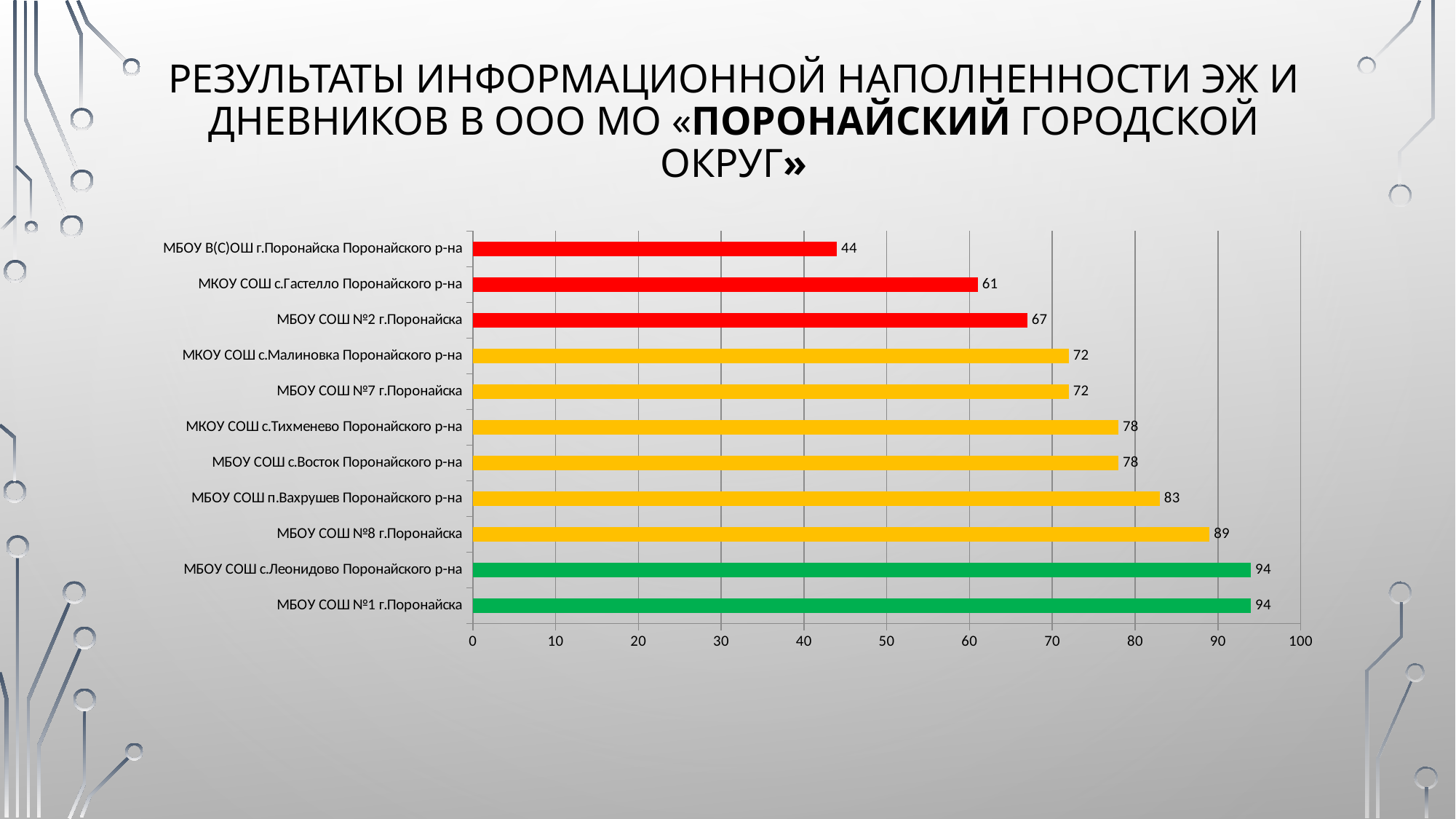
How many schools are shown on the chart? 11 Which has a larger value: МКОУ СОШ с.Тихменево Поронайского р-на or МКОУ СОШ с.Малиновка Поронайского р-на? МКОУ СОШ с.Тихменево Поронайского р-на What value is shown for МБОУ СОШ №8 г.Поронайска? 89 What kind of chart is shown on the slide? bar chart What value is shown for МКОУ СОШ с.Гастелло Поронайского р-на? 61 What is the difference between the values for МБОУ СОШ №8 г.Поронайска and МБОУ СОШ №2 г.Поронайска? 22 Is the value for МБОУ СОШ №2 г.Поронайска greater or less than 70? less What colour are the bars for the two schools with a value of 94? green What is the difference between the values for МБОУ СОШ №1 г.Поронайска and МБОУ В(С)ОШ г.Поронайска Поронайского р-на? 50 What is the highest value shown on the chart? 94 Which school has the lowest value on the chart? МБОУ В(С)ОШ г.Поронайска Поронайского р-на What value is shown for МБОУ СОШ п.Вахрушев Поронайского р-на? 83